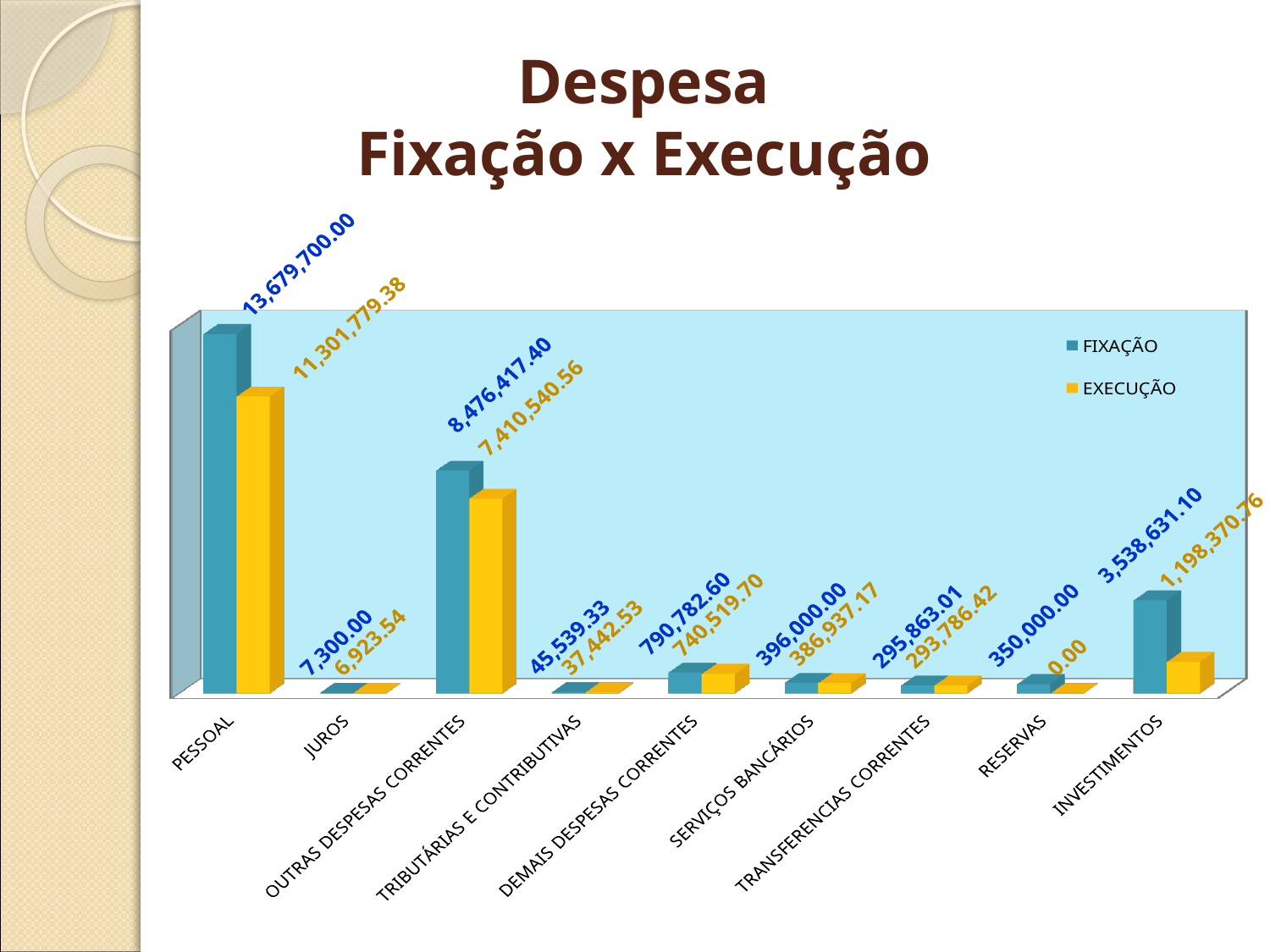
What is the EXECUÇÃO value for RESERVAS? 0.00 What is the difference between the FIXAÇÃO and EXECUÇÃO values for RESERVAS? 350,000.00 What kind of chart is shown on the slide? Bar chart What is the EXECUÇÃO value for INVESTIMENTOS? 1,198,370.76 What is the FIXAÇÃO value for PESSOAL? 13,679,700.00 How many series does the legend list? 2 How many categories are shown on the x axis? 9 Which category has the lowest EXECUÇÃO value? RESERVAS Which is larger: the EXECUÇÃO value for OUTRAS DESPESAS CORRENTES or the FIXAÇÃO value for INVESTIMENTOS? EXECUÇÃO value for OUTRAS DESPESAS CORRENTES What is the difference between the FIXAÇÃO and EXECUÇÃO values for JUROS? 376.46 Which category has the highest FIXAÇÃO value? PESSOAL What is the FIXAÇÃO value for SERVIÇOS BANCÁRIOS? 396,000.00